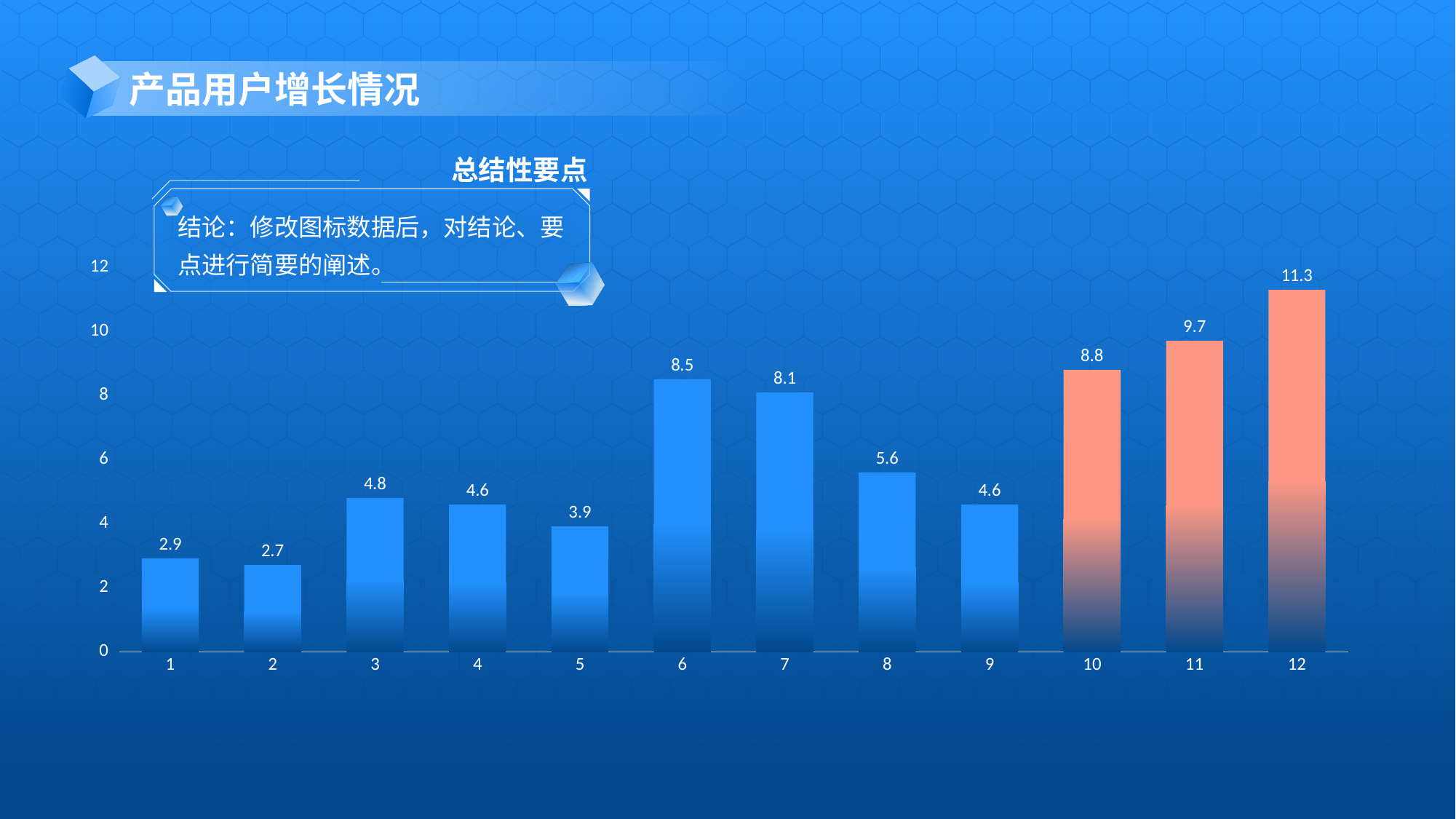
Which bars are coloured orange rather than blue? 10, 11 and 12 How many categories are shown on the x axis? 12 What is the value for category 12? 11.3 What is the value for category 2? 2.7 Which category has the highest value? 12 What kind of chart is shown on the slide? bar chart Is the value for category 10 greater or less than 8? greater What is the difference between the values for category 12 and category 11? 1.6 What is the value for category 6? 8.5 What is the difference between the values for category 6 and category 7? 0.4 Which is larger, the value for category 8 or the value for category 9? 8 Which category has the lowest value? 2